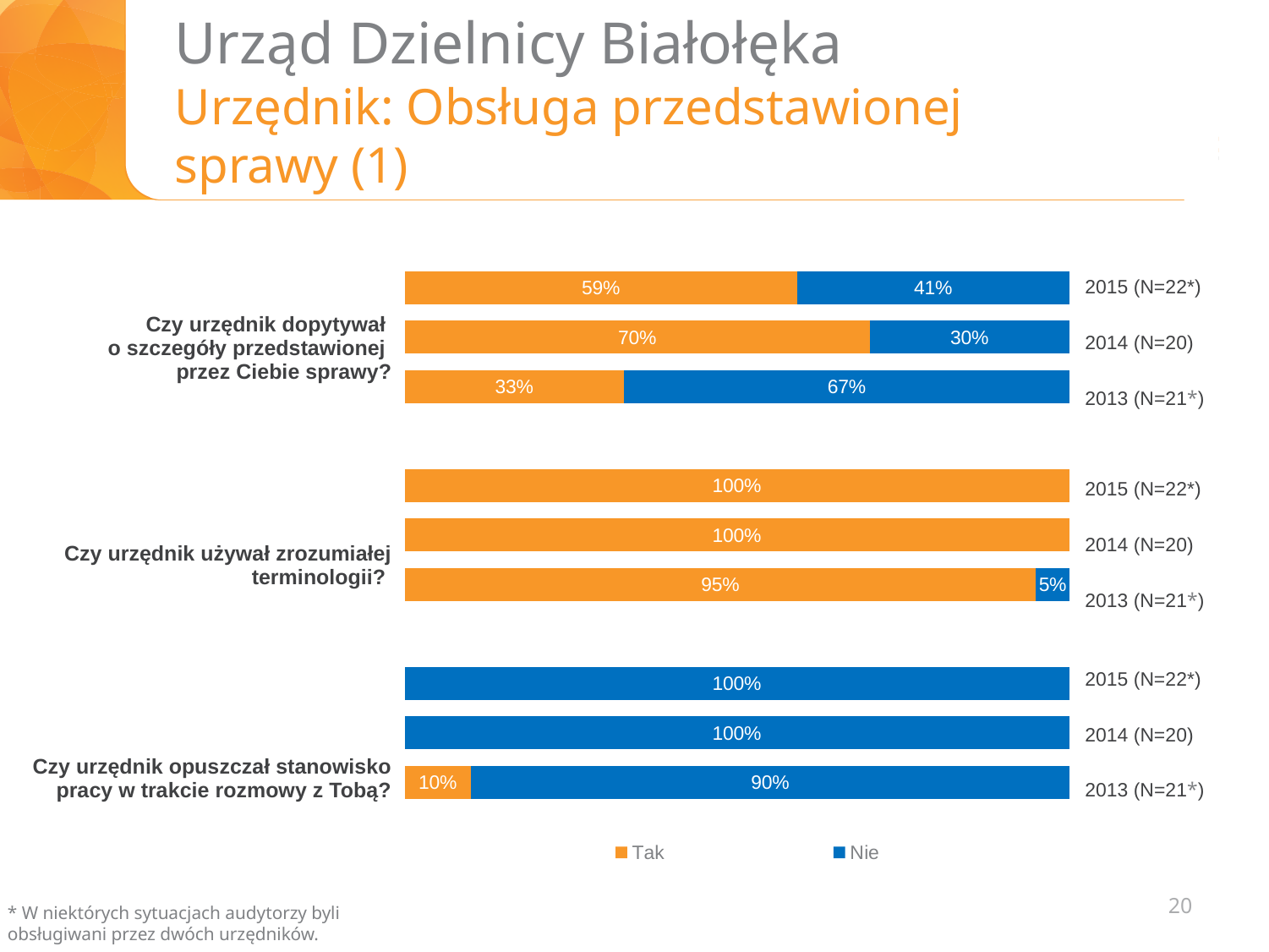
How many series does the legend list? 2 What is the 'Tak' value for 2015 (N=22*) for the question 'Czy urzędnik dopytywał o szczegóły przedstawionej przez Ciebie sprawy?' 59% How many bars are shown in the chart in total? 9 For the question 'Czy urzędnik używał zrozumiałej terminologii?', is the 'Tak' value for 2013 (N=21*) larger or smaller than the 'Tak' value for 2014 (N=20)? smaller What kind of chart is shown on the slide? stacked bar chart What is the 'Nie' value for 2013 (N=21*) for the question 'Czy urzędnik dopytywał o szczegóły przedstawionej przez Ciebie sprawy?' 67% What is the 'Tak' value for 2013 (N=21*) for the question 'Czy urzędnik opuszczał stanowisko pracy w trakcie rozmowy z Tobą?' 10% What are the two series named in the legend? Tak and Nie For the question 'Czy urzędnik dopytywał o szczegóły przedstawionej przez Ciebie sprawy?', which year has the lowest 'Tak' value? 2013 (N=21*) What is the difference between the 'Tak' values for 2014 (N=20) and 2015 (N=22*) for the question 'Czy urzędnik dopytywał o szczegóły przedstawionej przez Ciebie sprawy?' 11% For the question 'Czy urzędnik dopytywał o szczegóły przedstawionej przez Ciebie sprawy?', which year has the highest 'Tak' value? 2014 (N=20) What is the 'Tak' value for 2013 (N=21*) for the question 'Czy urzędnik używał zrozumiałej terminologii?' 95%